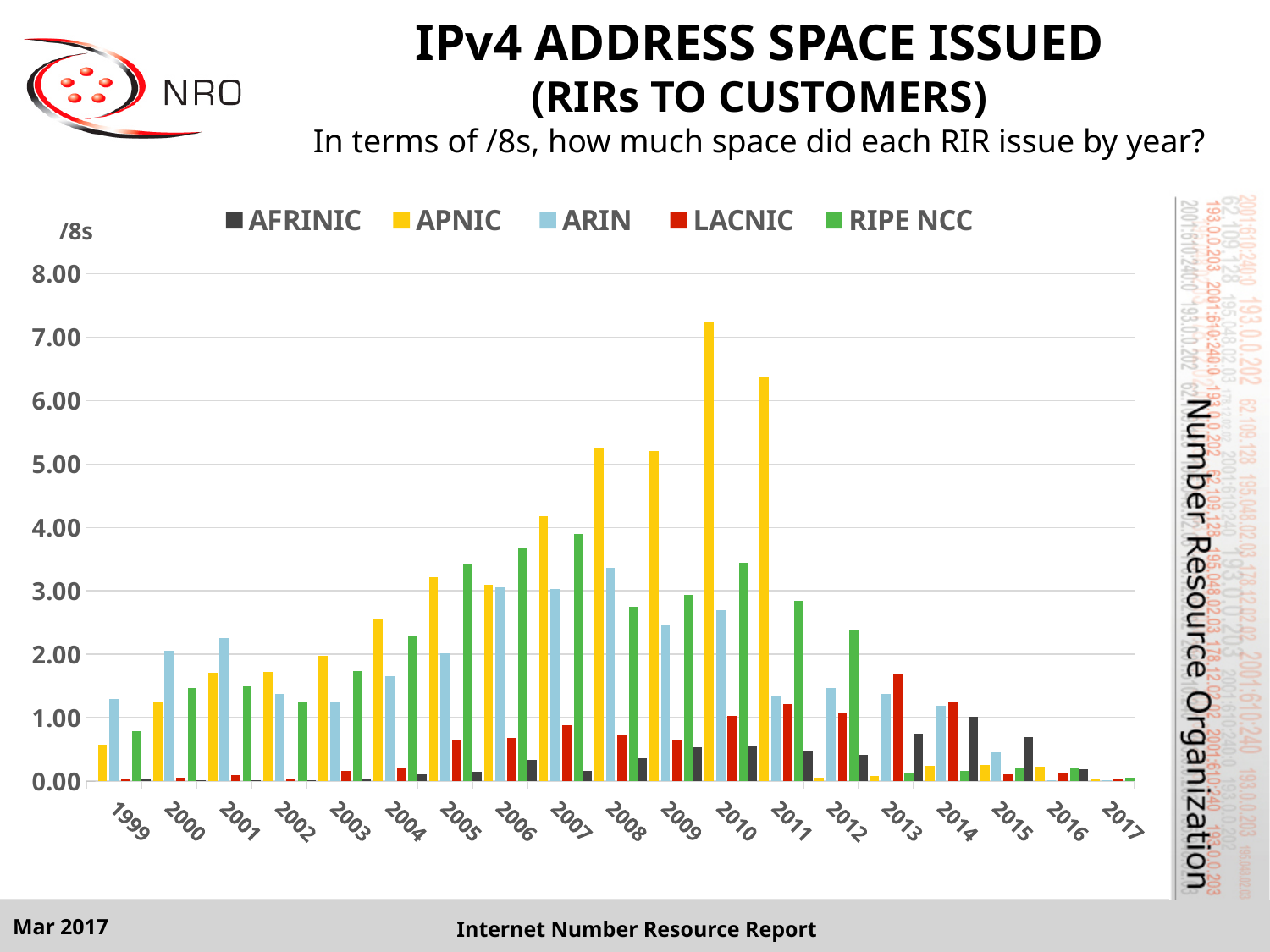
Is the value for LACNIC in 2013 greater or less than 1.00? greater Which is larger in 2000, the ARIN bar or the APNIC bar? ARIN What kind of chart is shown on the slide? bar chart What unit label is shown at the top of the y axis? /8s How many series does the legend list? 5 How many years are shown along the x axis? 19 In which year is the APNIC bar the highest? 2010 Is the value for APNIC in 2011 greater or less than 6.00? greater Which RIR has the highest bar in 2013? LACNIC Do the APNIC values rise or fall from 2011 to 2017? fall Is the value for RIPE NCC in 2007 greater or less than 3.00? greater